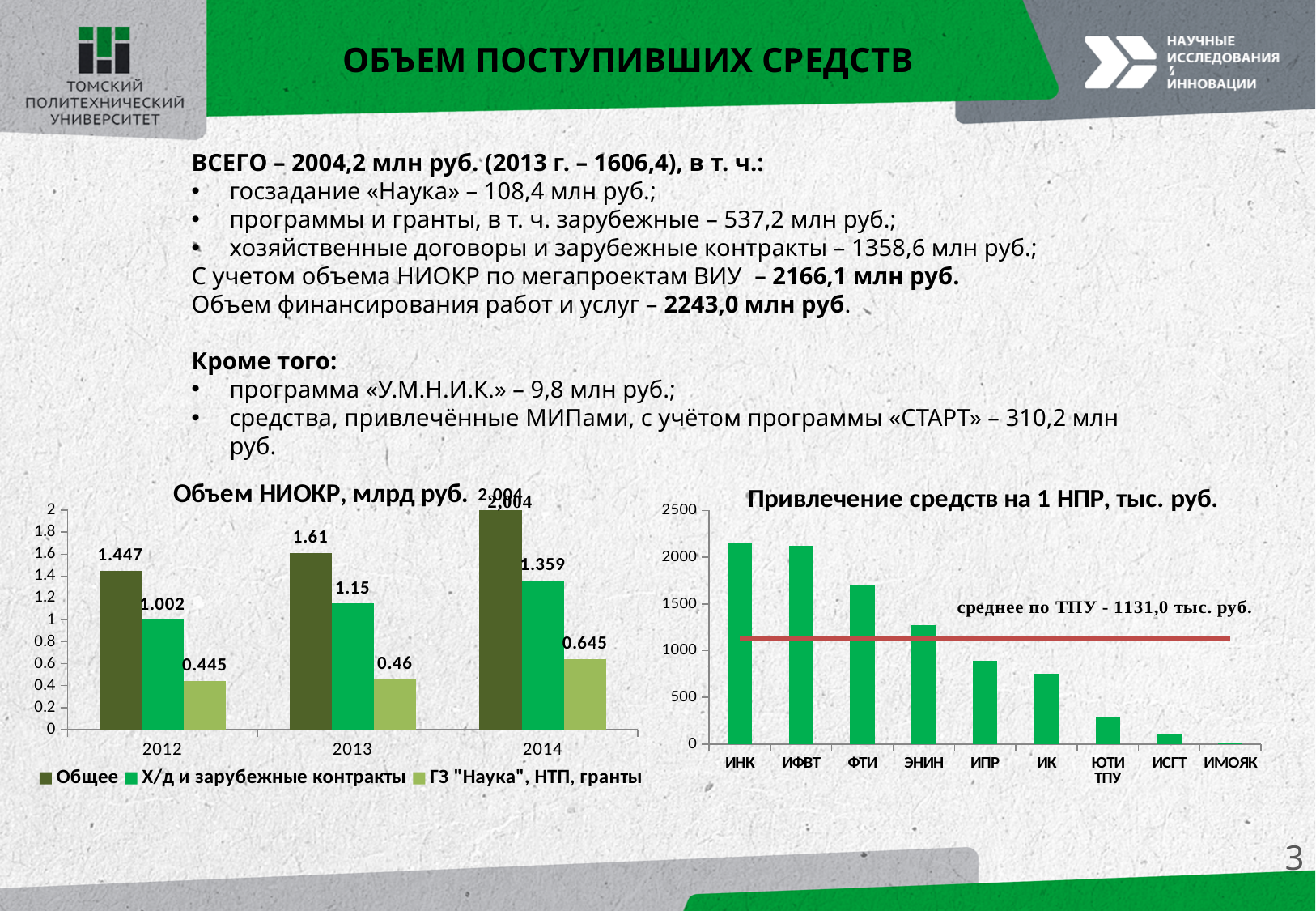
In the chart 'Объем НИОКР, млрд руб.', what is the value of 'ГЗ "Наука", НТП, гранты' for 2012? 0.445 How many series does the legend of the chart 'Объем НИОКР, млрд руб.' list? 3 In the chart 'Привлечение средств на 1 НПР, тыс. руб.', what average value for ТПУ is indicated by the red line? 1131,0 тыс. руб. What kind of chart is 'Привлечение средств на 1 НПР, тыс. руб.'? bar chart In the chart 'Объем НИОКР, млрд руб.', what is the difference between the 'Общее' values for 2014 and 2013? 0.394 In the chart 'Объем НИОКР, млрд руб.', what is the value of 'Х/д и зарубежные контракты' for 2013? 1.15 How many categories are shown in the chart 'Привлечение средств на 1 НПР, тыс. руб.'? 9 In the chart 'Объем НИОКР, млрд руб.', does the value of 'Общее' rise or fall from 2012 to 2014? rise In the chart 'Объем НИОКР, млрд руб.', what is the value of 'Общее' for 2014? 2.004 In the chart 'Привлечение средств на 1 НПР, тыс. руб.', which category has the highest value? ИНК In the chart 'Объем НИОКР, млрд руб.', which year has the highest value for 'Общее'? 2014 In the chart 'Привлечение средств на 1 НПР, тыс. руб.', is the value for ФТИ greater or less than 1500? greater